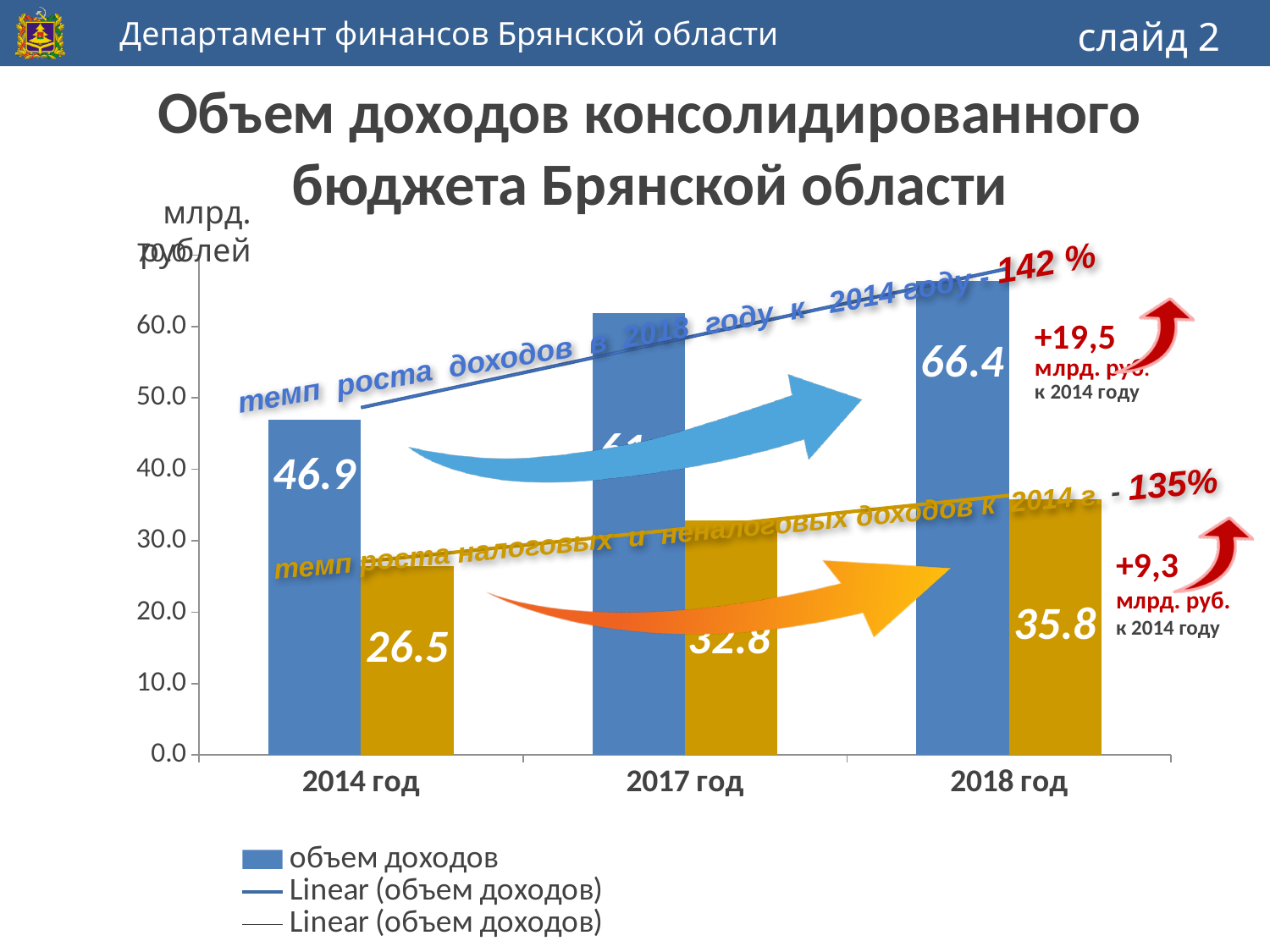
Is the value of объем доходов for 2017 год greater or less than 60.0? greater What is the difference between the yellow bar values for 2018 год and 2014 год? 9.3 By how much does объем доходов in 2018 год exceed that in 2014 год? 19.5 What is the value shown on the yellow bar for 2014 год? 26.5 In which year is объем доходов the lowest? 2014 год What is the value of объем доходов for 2018 год? 66.4 What is the value of объем доходов for 2014 год? 46.9 In which year is объем доходов the highest? 2018 год Do the объем доходов values rise or fall from 2014 год to 2018 год? rise How many years are shown on the x axis of the chart? 3 What kind of chart is shown on the slide? bar chart What is the value shown on the yellow bar for 2018 год? 35.8